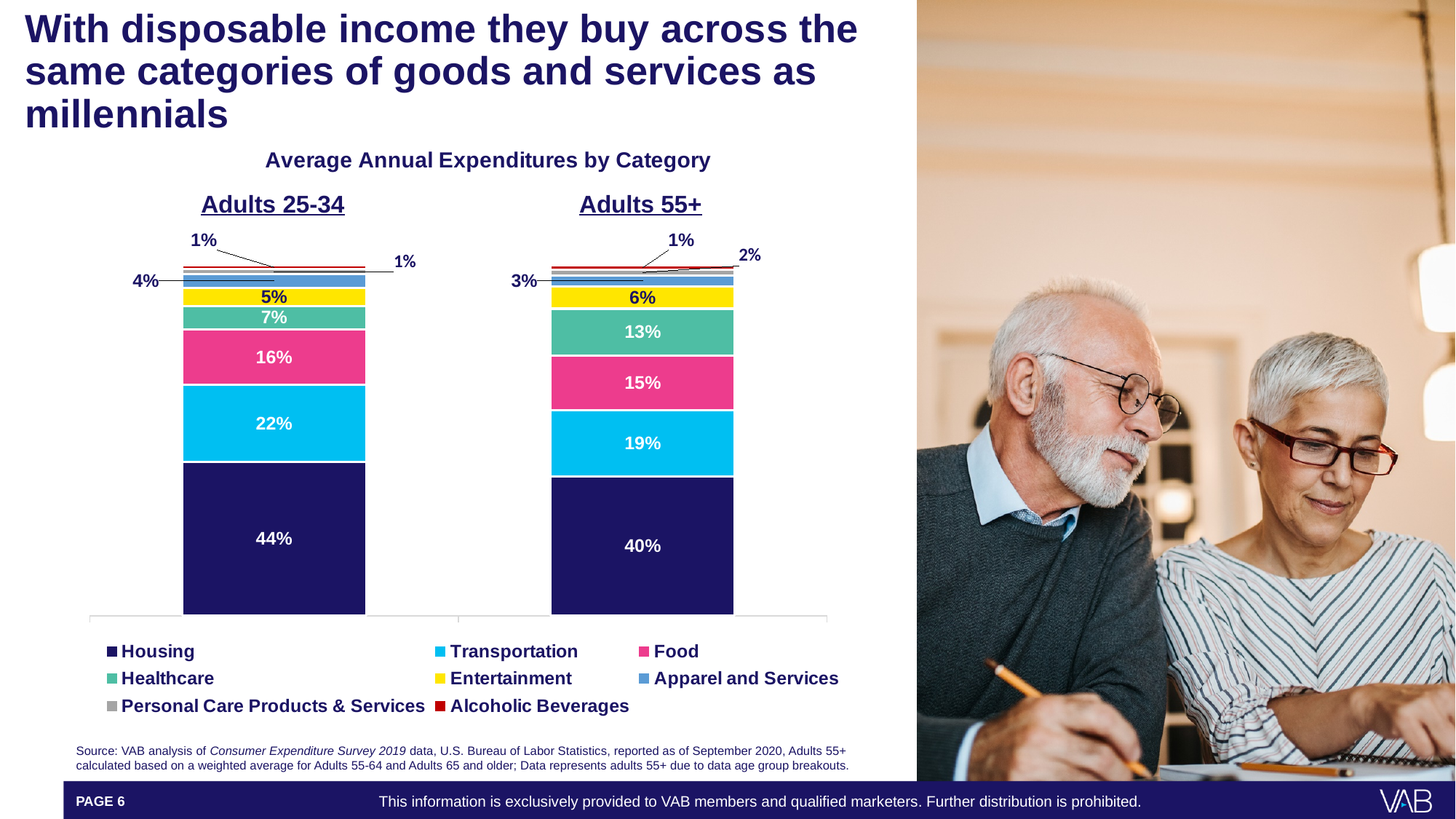
Which category has the largest share of expenditures for Adults 55+? Housing What is the Transportation share for Adults 55+? 19% What share of average annual expenditures does Healthcare account for among Adults 55+? 13% How many series does the legend list? 8 How many age groups (bars) are shown in the chart? 2 What is the difference between the Housing share for Adults 25-34 and for Adults 55+? 4% What is the Entertainment share for Adults 25-34? 5% What kind of chart is shown under the title "Average Annual Expenditures by Category"? Stacked bar chart What share of average annual expenditures does Housing account for among Adults 25-34? 44% Which colour represents Food in the chart? Pink Which group has the larger Healthcare share, Adults 25-34 or Adults 55+? Adults 55+ What is the difference between the Healthcare share for Adults 55+ and for Adults 25-34? 6%